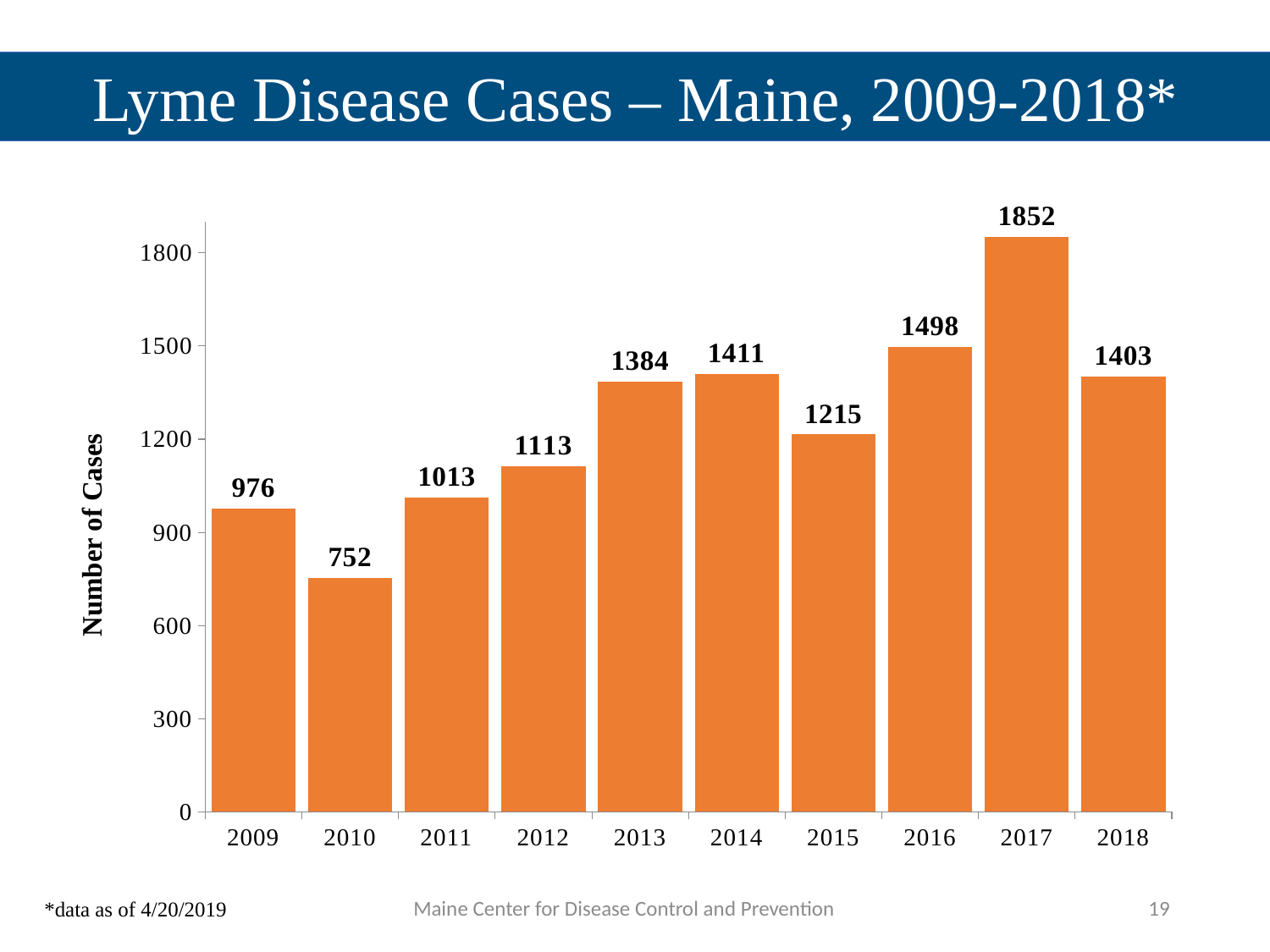
Which year had more cases, 2014 or 2018? 2014 How many years are shown on the x axis of the chart? 10 What kind of chart is shown on the slide? bar chart What is the difference in cases between 2017 and 2018? 449 Which year had the highest number of Lyme disease cases? 2017 What is the label on the vertical axis of the chart? Number of Cases Which year had the lowest number of Lyme disease cases? 2010 Is the value for 2012 greater or less than 1200? less How many Lyme disease cases were reported in Maine in 2013? 1384 What is the number of cases shown for 2010? 752 Did the number of cases rise or fall from 2010 to 2013? rise How many more cases were there in 2016 than in 2015? 283